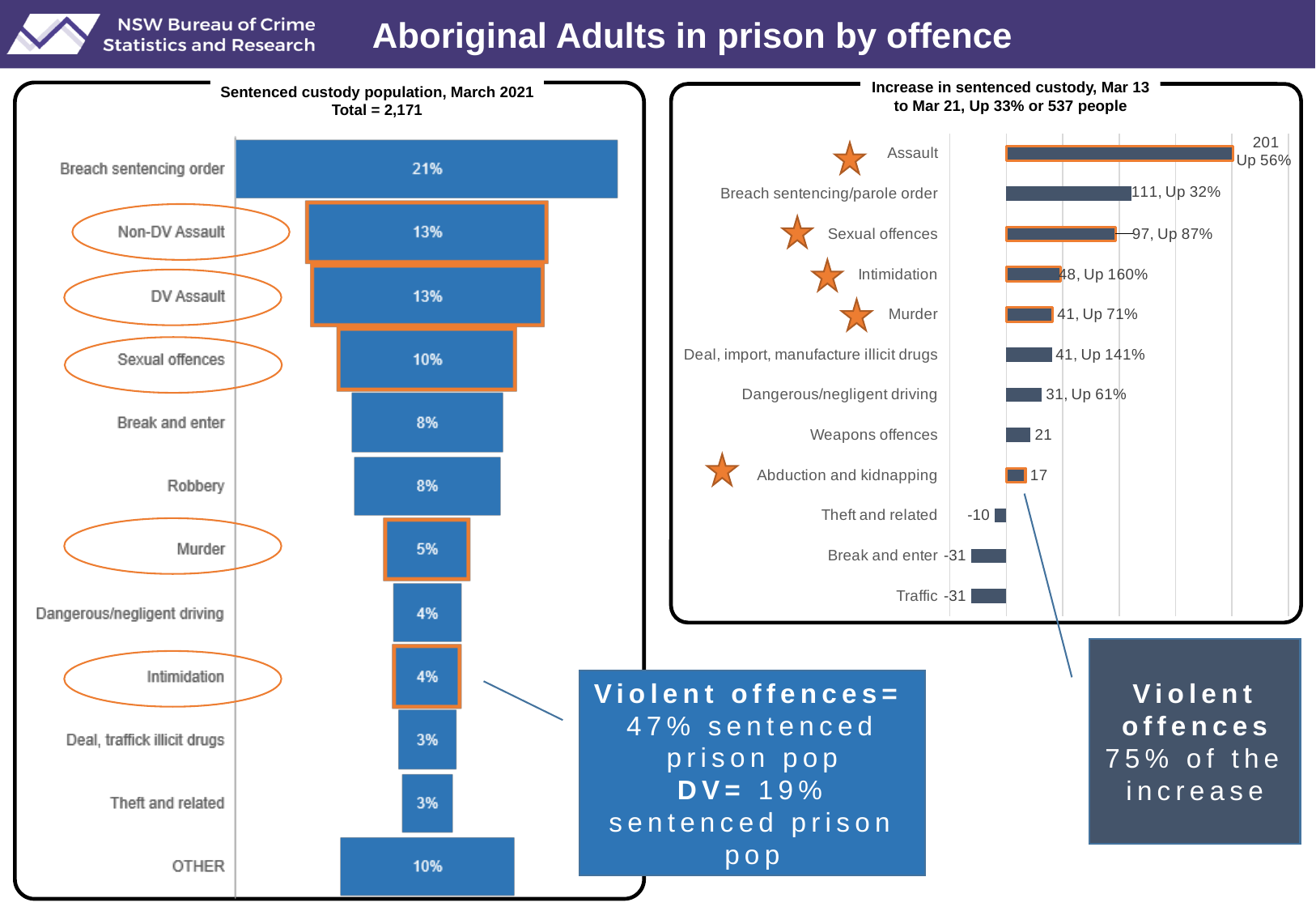
In the 'Increase in sentenced custody, Mar 13 to Mar 21' chart, what is the difference between the increase for Assault and the increase for Sexual offences? 104 In the 'Increase in sentenced custody, Mar 13 to Mar 21' chart, what is the increase shown for Assault? 201 In the 'Increase in sentenced custody, Mar 13 to Mar 21' chart, what percentage increase is shown for Intimidation? Up 160% In the 'Sentenced custody population, March 2021' chart, what is the difference in percentage points between Non-DV Assault and Murder? 8 In the 'Sentenced custody population, March 2021' chart, how many offence categories are listed? 12 In the 'Sentenced custody population, March 2021' chart, what percentage is shown for Breach sentencing order? 21% In the 'Sentenced custody population, March 2021' chart, what percentage is shown for Sexual offences? 10% In the 'Increase in sentenced custody, Mar 13 to Mar 21' chart, what value is shown for Theft and related? -10 In the 'Sentenced custody population, March 2021' chart, which offence category has the highest percentage? Breach sentencing order In the 'Increase in sentenced custody, Mar 13 to Mar 21' chart, which is larger: the increase for Sexual offences or for Breach sentencing/parole order? Breach sentencing/parole order In the 'Increase in sentenced custody, Mar 13 to Mar 21' chart, which offence category has the largest increase in people? Assault What type of chart is the 'Increase in sentenced custody, Mar 13 to Mar 21' chart? Bar chart